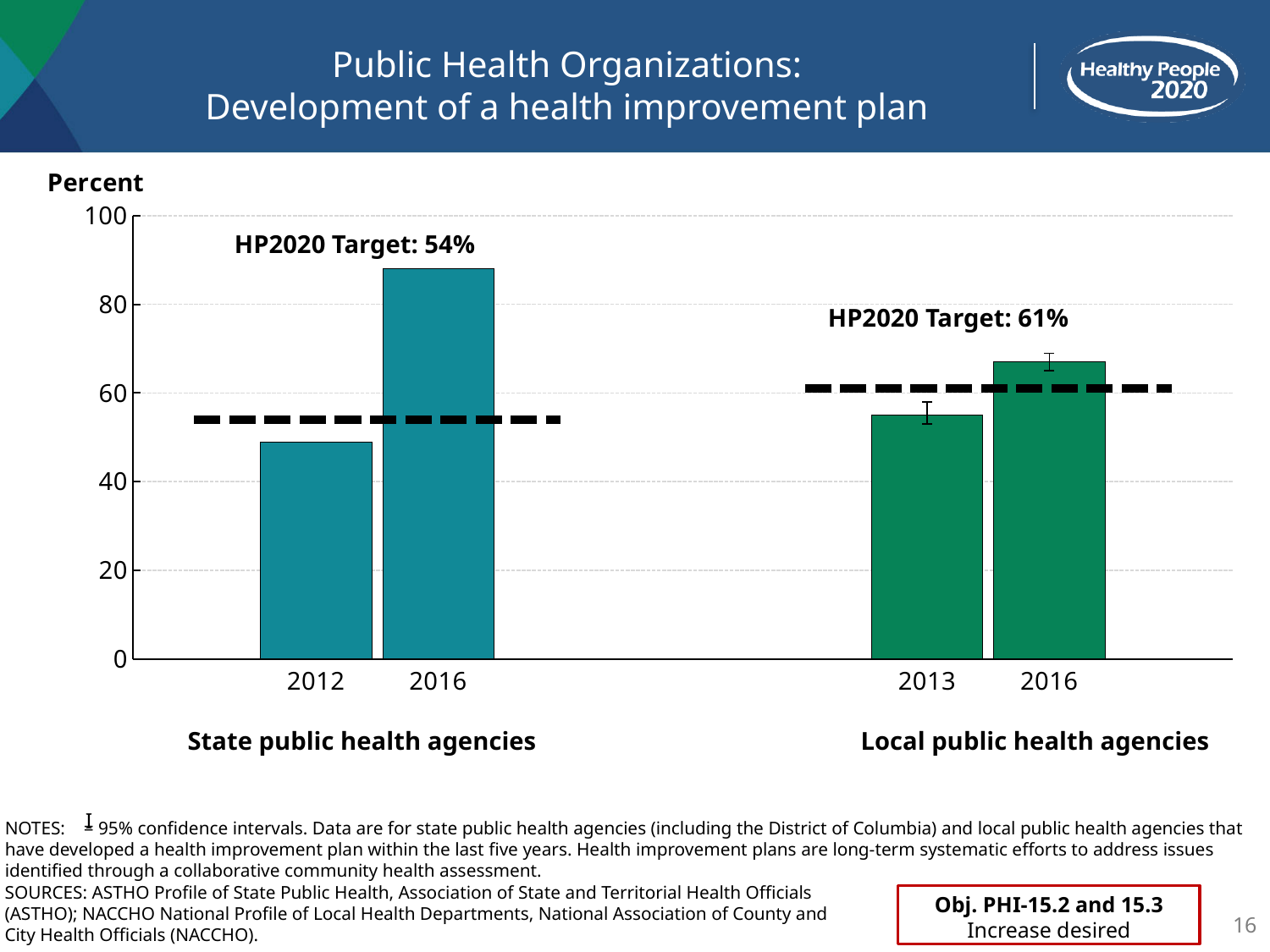
What kind of chart is shown on the slide? bar chart Which is larger: the 2016 value for state public health agencies or the 2016 value for local public health agencies? State public health agencies Is the value for local public health agencies in 2016 greater or less than 60? greater Which bar has the lowest value in the chart? State public health agencies, 2012 What is the HP2020 Target shown for local public health agencies? 61% Which bar has the highest value in the chart? State public health agencies, 2016 What is the HP2020 Target shown for state public health agencies? 54% Is the value for local public health agencies in 2013 greater or less than 60? less Did the value for local public health agencies rise or fall from 2013 to 2016? rise Is the value for state public health agencies in 2016 greater or less than 80? greater How many bars are plotted in the chart? 4